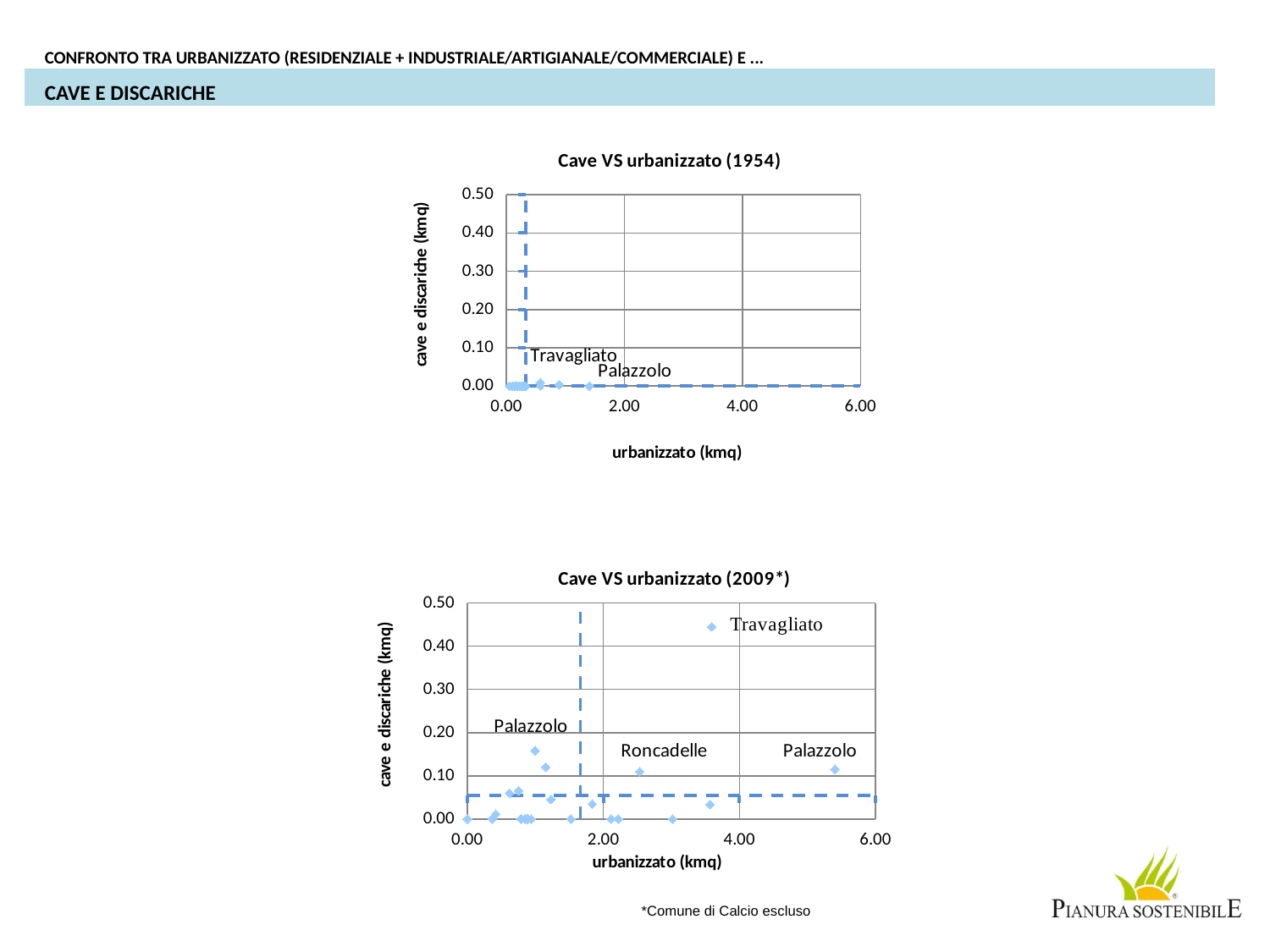
What kind of chart is the top chart titled "Cave VS urbanizzato (1954)"? scatter chart In the top chart "Cave VS urbanizzato (1954)", is the vertical-axis value for Travagliato greater or less than 0.10? less What is the label of the vertical axis on the top chart "Cave VS urbanizzato (1954)"? cave e discariche (kmq) In the bottom chart "Cave VS urbanizzato (2009*)", which labelled point has the highest value on the vertical axis? Travagliato In the bottom chart "Cave VS urbanizzato (2009*)", is the horizontal-axis value for Travagliato greater or less than 2.00? greater In the bottom chart "Cave VS urbanizzato (2009*)", which has the higher vertical-axis value, Travagliato or Roncadelle? Travagliato In the bottom chart "Cave VS urbanizzato (2009*)", is the vertical-axis value for Travagliato greater or less than 0.40? greater What kind of chart is the bottom chart titled "Cave VS urbanizzato (2009*)"? scatter chart What is the label of the horizontal axis on the bottom chart "Cave VS urbanizzato (2009*)"? urbanizzato (kmq) In the bottom chart "Cave VS urbanizzato (2009*)", which point lies further right on the horizontal axis, Roncadelle or the rightmost Palazzolo point? Palazzolo